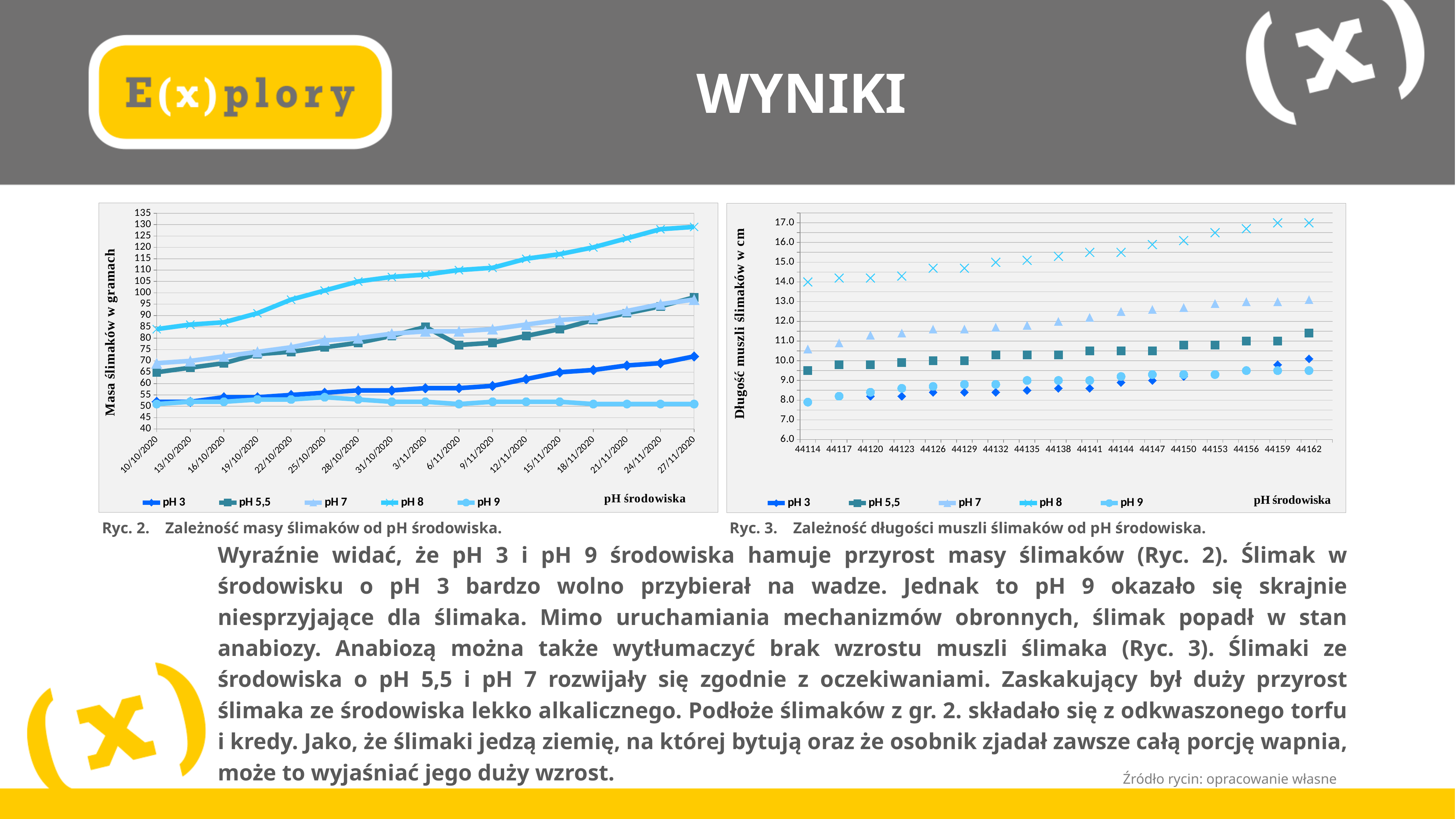
In Ryc. 2, which series has the highest value on 27/11/2020? pH 8 How many x-axis points are shown in Ryc. 3? 17 In Ryc. 2, is the value for pH 3 on 10/10/2020 greater or less than 55? less In Ryc. 2, which is larger on 27/11/2020: pH 7 or pH 3? pH 7 In Ryc. 3, is the value for pH 8 at 44162 greater or less than 16.0? greater What kind of chart is Ryc. 3 (the right chart)? scatter chart How many series does the legend of Ryc. 2 list? 5 In Ryc. 2, does the pH 8 series rise or fall over the dates shown? rises In Ryc. 2, which series has the lowest value on 27/11/2020? pH 9 In Ryc. 2, is the value for pH 8 on 27/11/2020 greater or less than 125? greater In Ryc. 3, which series has the highest value at 44162? pH 8 What kind of chart is Ryc. 2 (the left chart)? line chart